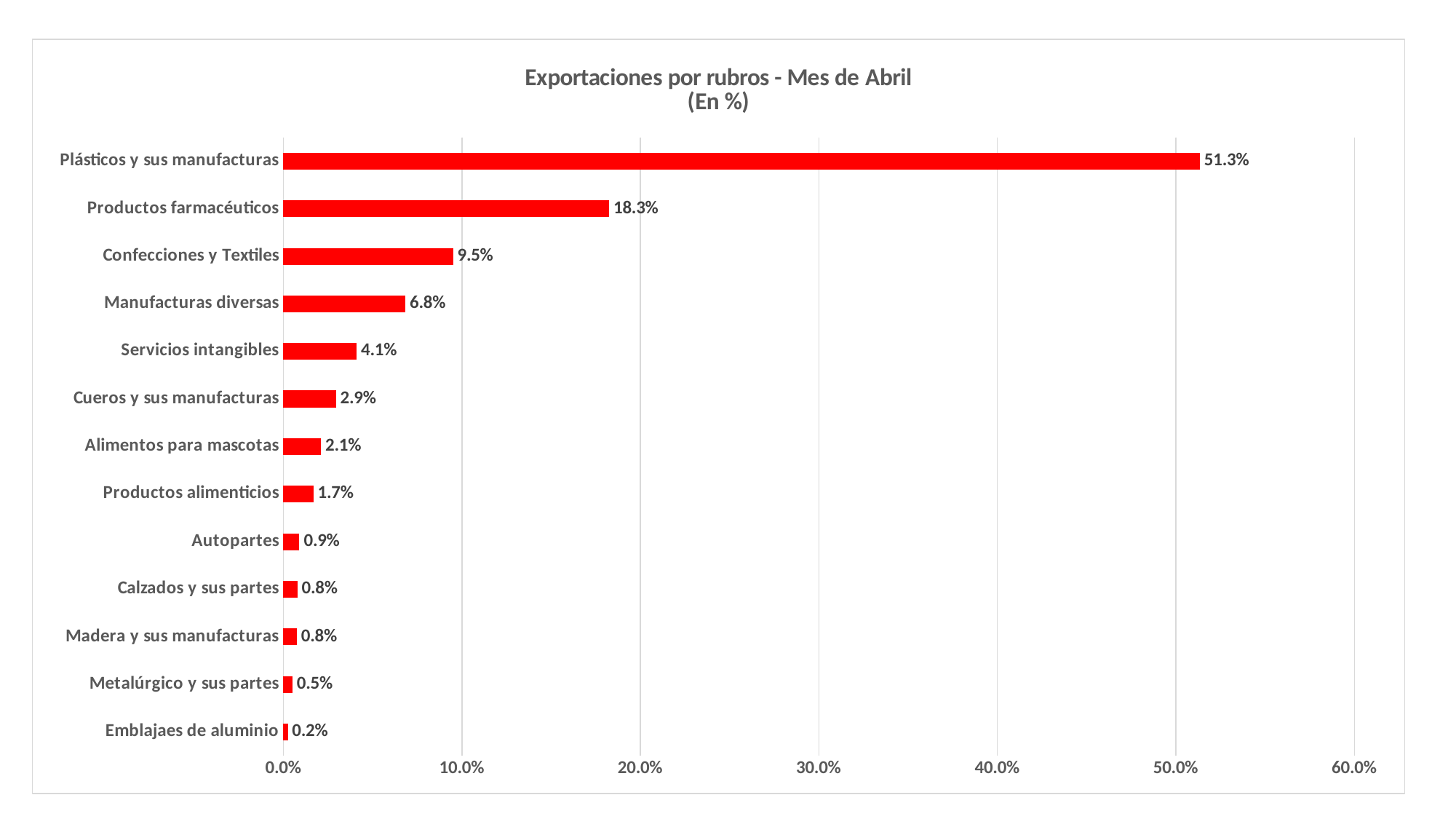
What is the difference between Plásticos y sus manufacturas and Productos farmacéuticos? 33.0% Which is larger, Cueros y sus manufacturas or Alimentos para mascotas? Cueros y sus manufacturas How many categories are shown in the chart? 13 What is the value for Productos farmacéuticos? 18.3% Is the value for Productos farmacéuticos greater or less than 20.0%? less What kind of chart is shown on the slide? bar chart What is the difference between Confecciones y Textiles and Manufacturas diversas? 2.7% What is the value for Plásticos y sus manufacturas? 51.3% Which category has the highest value? Plásticos y sus manufacturas Which category has the lowest value? Emblajaes de aluminio What is the value for Metalúrgico y sus partes? 0.5% What is the value for Servicios intangibles? 4.1%